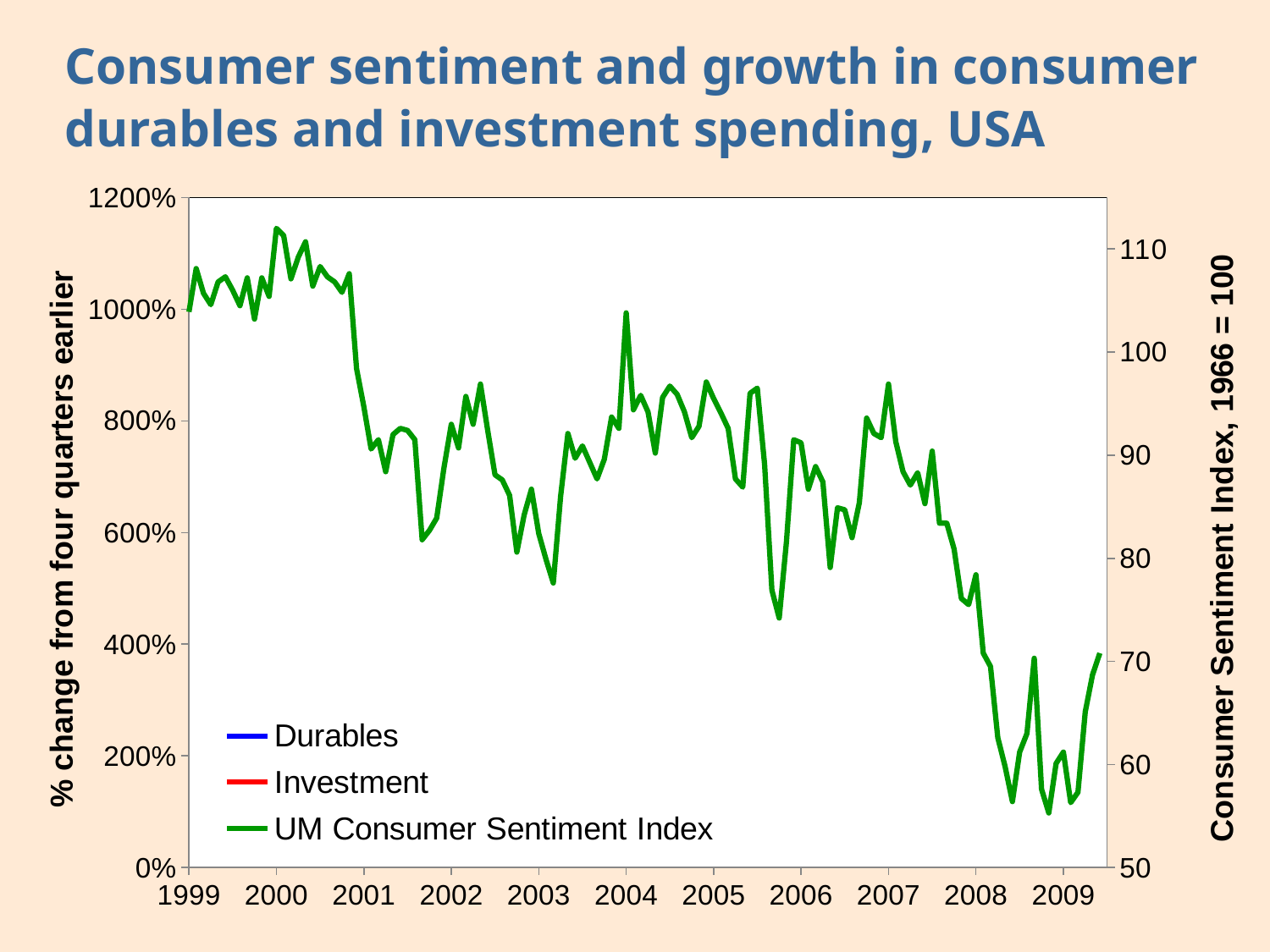
Is the UM Consumer Sentiment Index at its peak around 2000 greater or less than 110? greater What kind of chart is shown on the slide? line chart Does the UM Consumer Sentiment Index overall rise or fall between 1999 and 2009? fall Is the UM Consumer Sentiment Index at the start of 1999 greater or less than 100? greater Which series is drawn in green? UM Consumer Sentiment Index Is the UM Consumer Sentiment Index at its peak around the start of 2004 greater or less than 100? greater How many series does the legend list? 3 Is the UM Consumer Sentiment Index higher around 2000 or around 2008? around 2000 What is the title of the right-hand vertical axis? Consumer Sentiment Index, 1966 = 100 How many year labels are shown on the x axis? 11